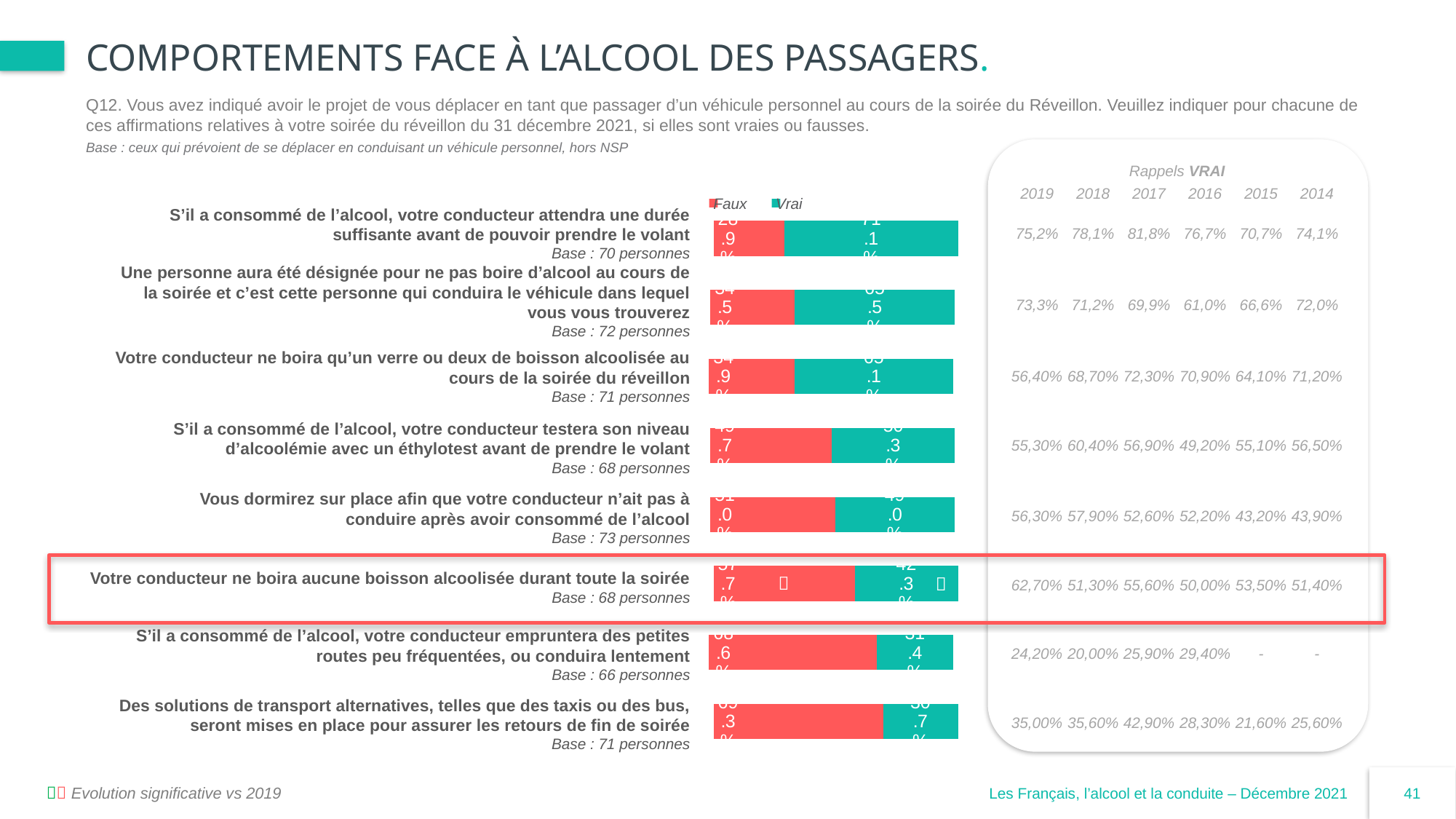
Which statement in the chart is highlighted with a red box? Votre conducteur ne boira aucune boisson alcoolisée durant toute la soirée What kind of chart is shown on the slide? Stacked bar chart For the statement 'S'il a consommé de l'alcool, votre conducteur attendra une durée suffisante avant de pouvoir prendre le volant', which is larger: Faux or Vrai? Vrai What are the two series named in the chart legend? Faux and Vrai How many series does the chart legend list? 2 For the statement 'Votre conducteur ne boira aucune boisson alcoolisée durant toute la soirée', which is larger: Faux or Vrai? Faux How many statements (categories) are plotted in the chart? 8 For the statement 'S'il a consommé de l'alcool, votre conducteur empruntera des petites routes peu fréquentées, ou conduira lentement', which is larger: Faux or Vrai? Faux Which colour represents the 'Vrai' series in the chart? Teal (green)